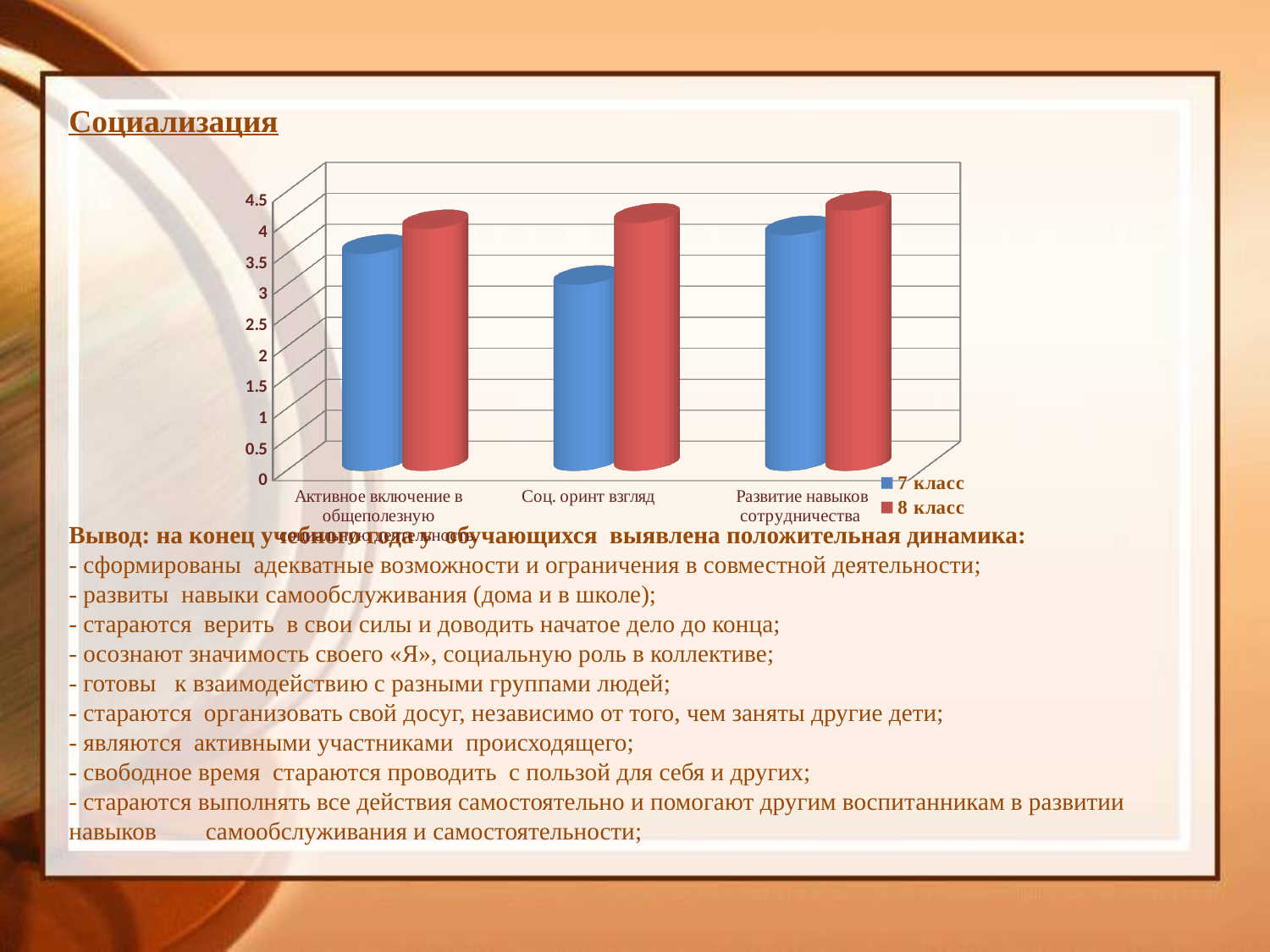
For the series '7 класс', which category has the lowest value? Соц. оринт взгляд Is the value for '7 класс' in the category 'Соц. оринт взгляд' greater or less than 3.5? less Which series are listed in the chart legend? 7 класс and 8 класс Is the value for '8 класс' in the category 'Развитие навыков сотрудничества' greater or less than 3.5? greater For the series '7 класс', which category has the highest value? Развитие навыков сотрудничества How many categories are shown on the x axis of the chart? 3 What kind of chart is shown on the slide? bar chart In the category 'Соц. оринт взгляд', which series has the larger value, '7 класс' or '8 класс'? 8 класс Is the value for '7 класс' in the category 'Соц. оринт взгляд' greater or less than 2.5? greater How many series does the chart legend list? 2 Which colour represents the series '7 класс' in the chart? blue